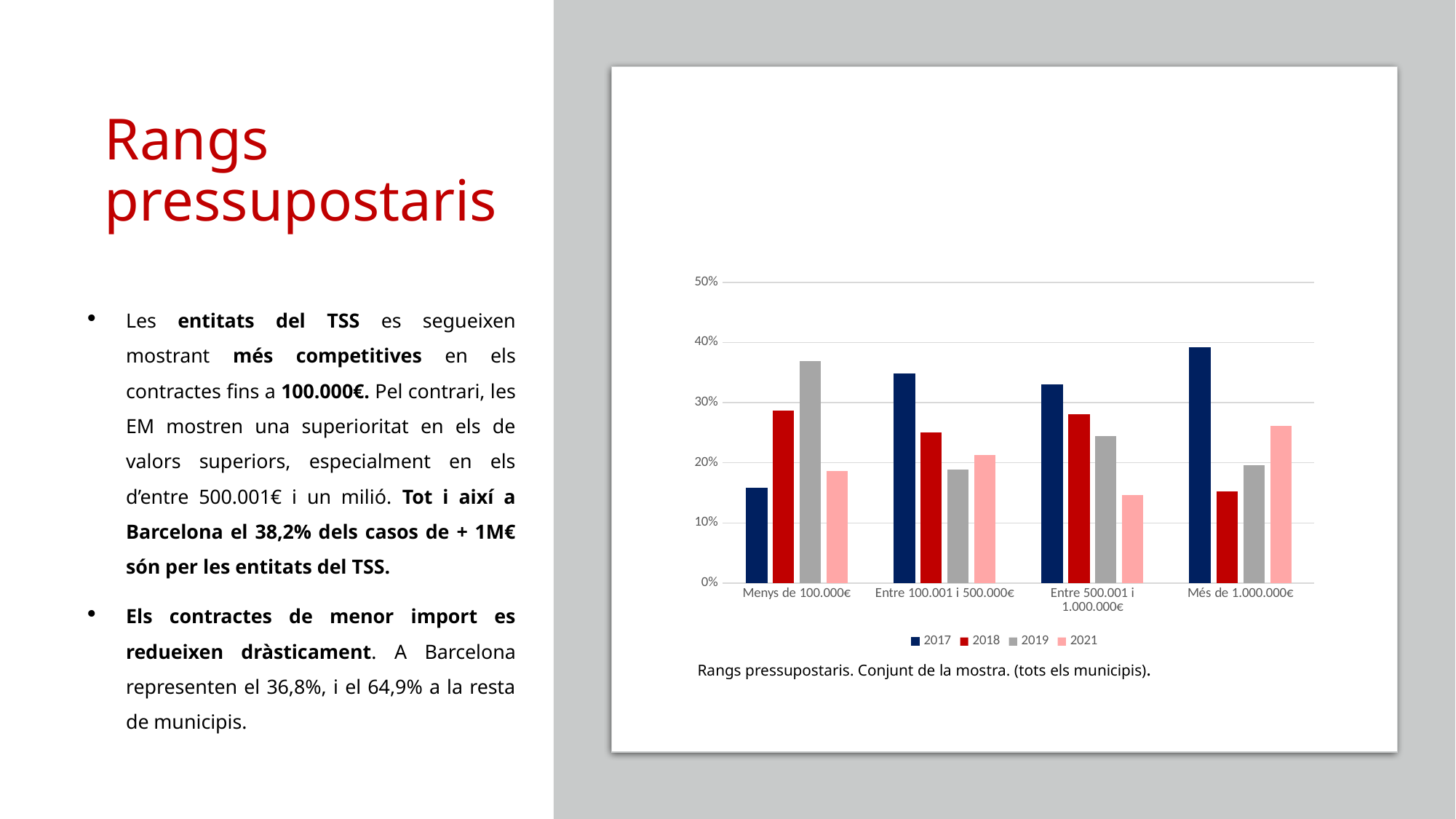
In the Menys de 100.000€ category, which is larger: the 2018 value or the 2021 value? 2018 Is the 2021 value for Entre 500.001 i 1.000.000€ greater or less than 20%? less Which years are listed in the chart's legend? 2017, 2018, 2019, 2021 For the 2017 series, which category has the highest value? Més de 1.000.000€ How many series does the legend of the chart list? 4 For the 2019 series, which category has the highest value? Menys de 100.000€ For the 2017 series, which category has the lowest value? Menys de 100.000€ How many budget range categories are shown on the x axis of the chart? 4 What kind of chart is shown on the slide? Bar chart For the 2018 series, which category has the lowest value? Més de 1.000.000€ Is the 2017 value for Entre 100.001 i 500.000€ greater or less than 30%? greater Is the 2019 value for Menys de 100.000€ greater or less than 30%? greater